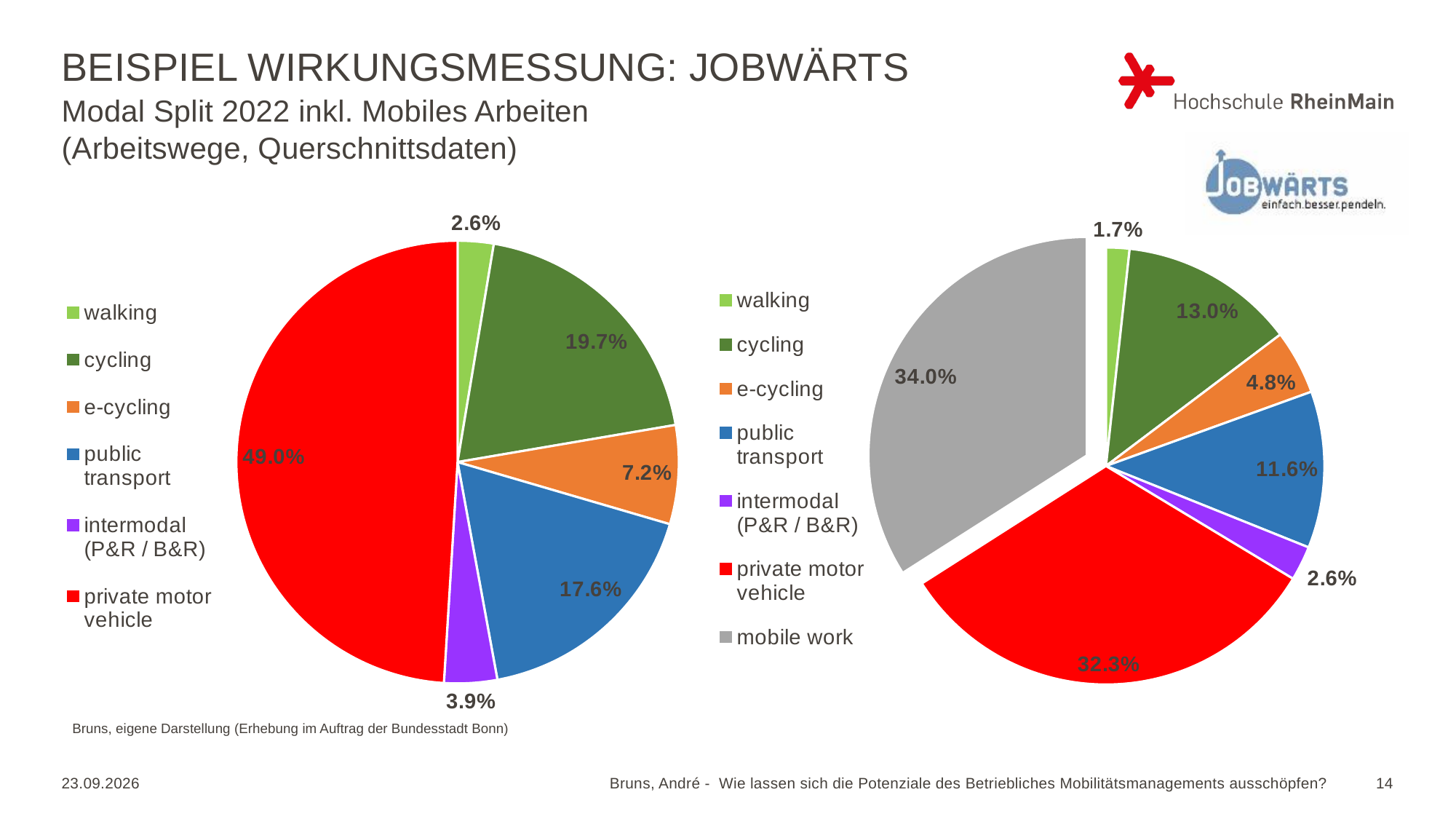
In the right pie chart, which category is shown in grey? mobile work In the left pie chart, what is the value for cycling? 19.7% What type of chart is shown on the left of the slide? pie chart In the left pie chart, which category has the smallest share? walking How many categories does the legend of the right pie chart list? 7 In the left pie chart, what share does private motor vehicle have? 49.0% How many slices does the left pie chart have? 6 In the left pie chart, what is the difference between the shares of cycling and public transport? 2.1% In the right pie chart, what is the value for public transport? 11.6% In the right pie chart, what share does mobile work have? 34.0% In the right pie chart, which category has the largest share? mobile work In the right pie chart, which is larger: cycling or e-cycling? cycling